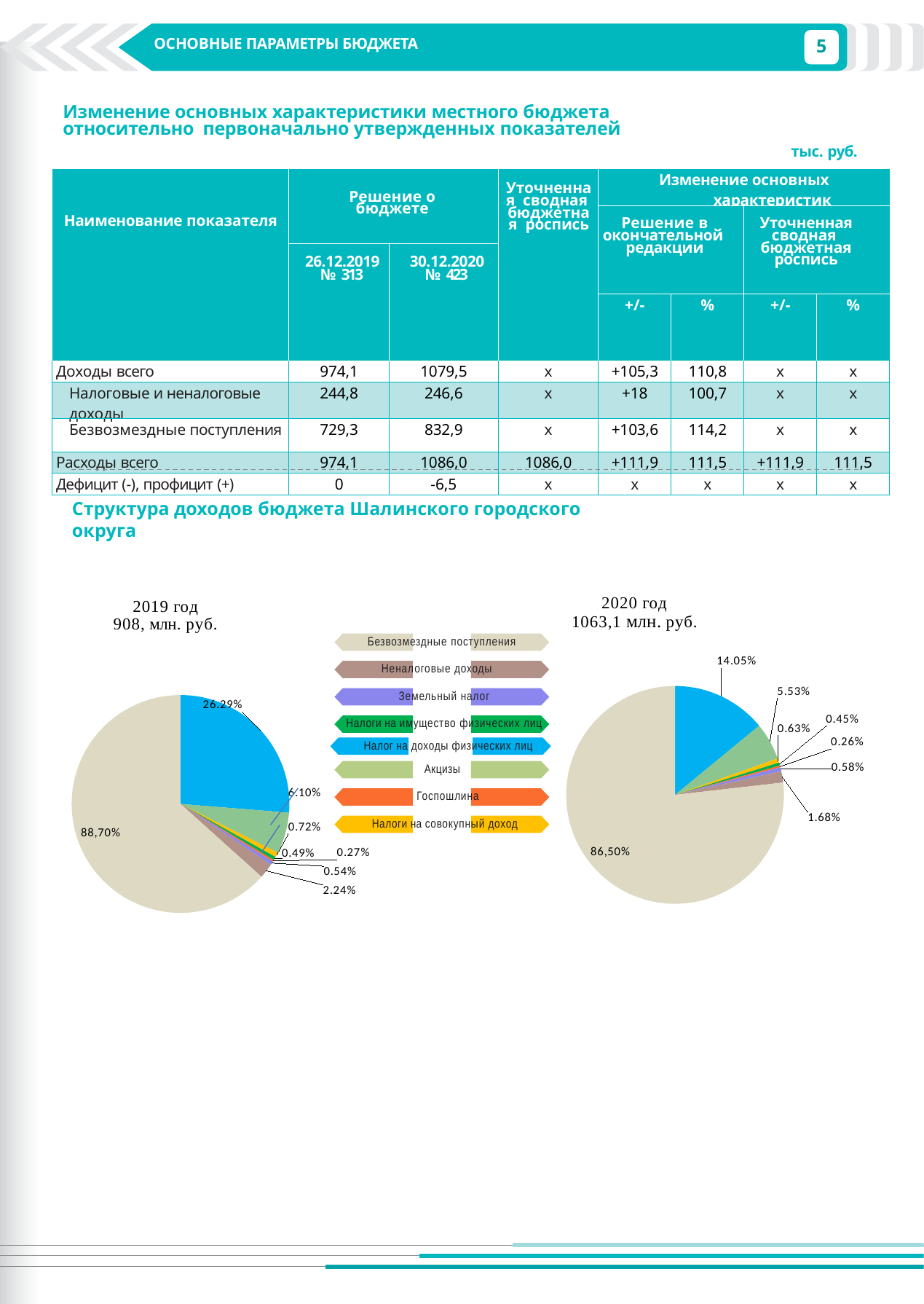
In the 2020 год pie chart, what share is labelled for Неналоговые доходы (the brown slice)? 1.68% In the 2020 год pie chart, what share is labelled for Акцизы (the light green slice)? 5.53% In the 2019 год pie chart, what share is labelled for Неналоговые доходы (the brown slice)? 2.24% In the 2020 год pie chart, which category has the largest slice? Безвозмездные поступления How many revenue categories does the shared legend between the two pie charts list? 8 What total revenue amount is shown in the title of the 2020 год pie chart? 1063,1 млн. руб. By how many percentage points does the labelled share of Налог на доходы физических лиц in the 2019 год pie chart exceed that in the 2020 год pie chart? 12.24 percentage points Is the share of Налог на доходы физических лиц larger in the 2019 год pie chart or the 2020 год pie chart? 2019 год In the 2019 год pie chart, what share is labelled for Налог на доходы физических лиц (the blue slice)? 26.29% In the 2019 год pie chart, what share is labelled for Акцизы (the light green slice)? 6.10% What type of chart is used to show the structure of budget revenues for 2019 and 2020? Pie chart In the 2020 год pie chart, what share is labelled for Налог на доходы физических лиц (the blue slice)? 14.05%